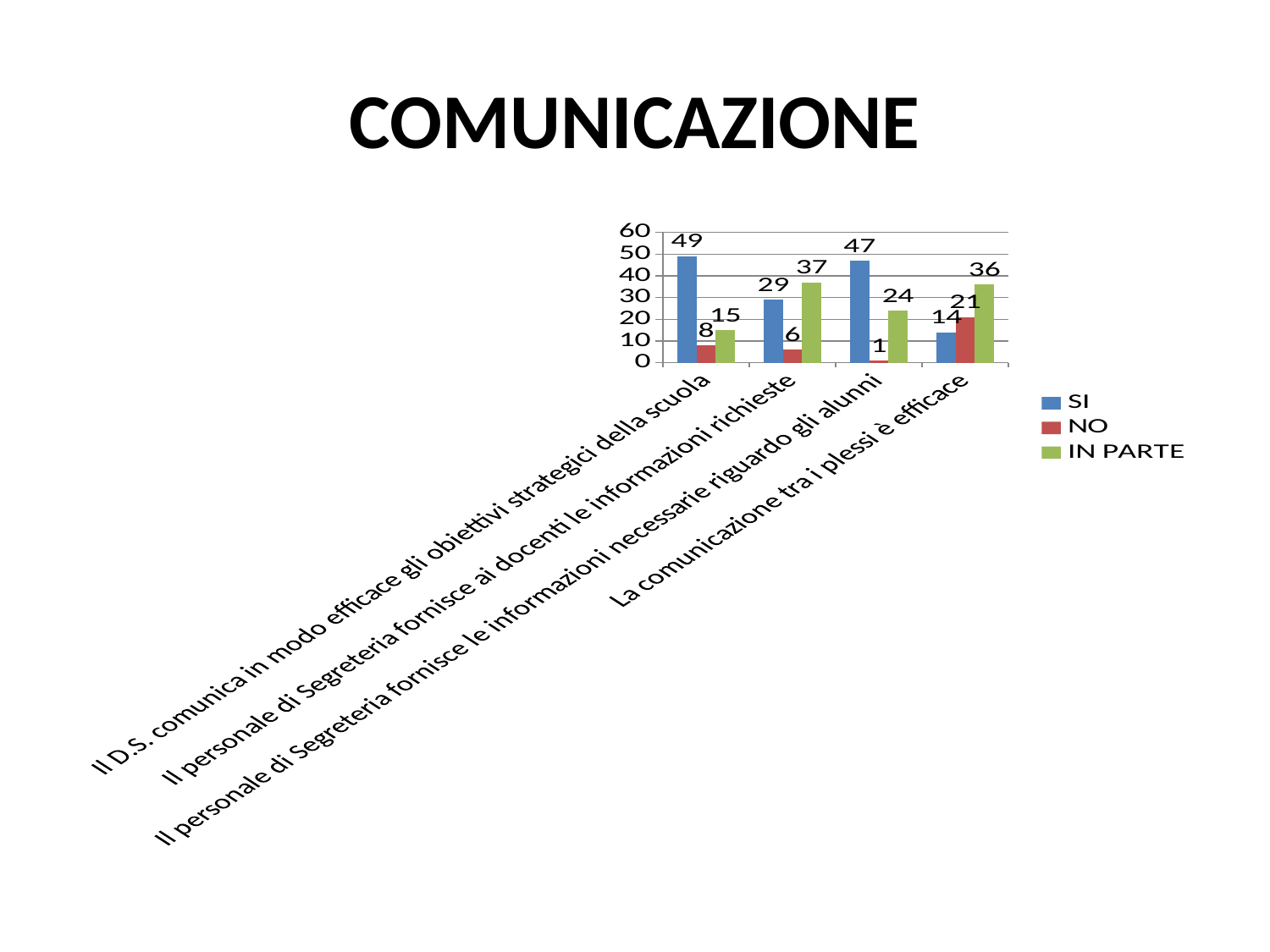
What is the SI value for "Il D.S. comunica in modo efficace gli obiettivi strategici della scuola"? 49 What is the NO value for "Il personale di Segreteria fornisce le informazioni necessarie riguardo gli alunni"? 1 What is the IN PARTE value for "Il personale di Segreteria fornisce ai docenti le informazioni richieste"? 37 Which category has the highest SI value? Il D.S. comunica in modo efficace gli obiettivi strategici della scuola What is the NO value for "La comunicazione tra i plessi è efficace"? 21 How many series does the legend list? 3 Which category has the lowest SI value? La comunicazione tra i plessi è efficace How many categories are shown on the x axis? 4 What is the title of the slide? COMUNICAZIONE What kind of chart is shown on the slide? Bar chart What is the difference between the SI and NO values for "La comunicazione tra i plessi è efficace"? 7 For "Il personale di Segreteria fornisce ai docenti le informazioni richieste", which is larger: SI or IN PARTE? IN PARTE